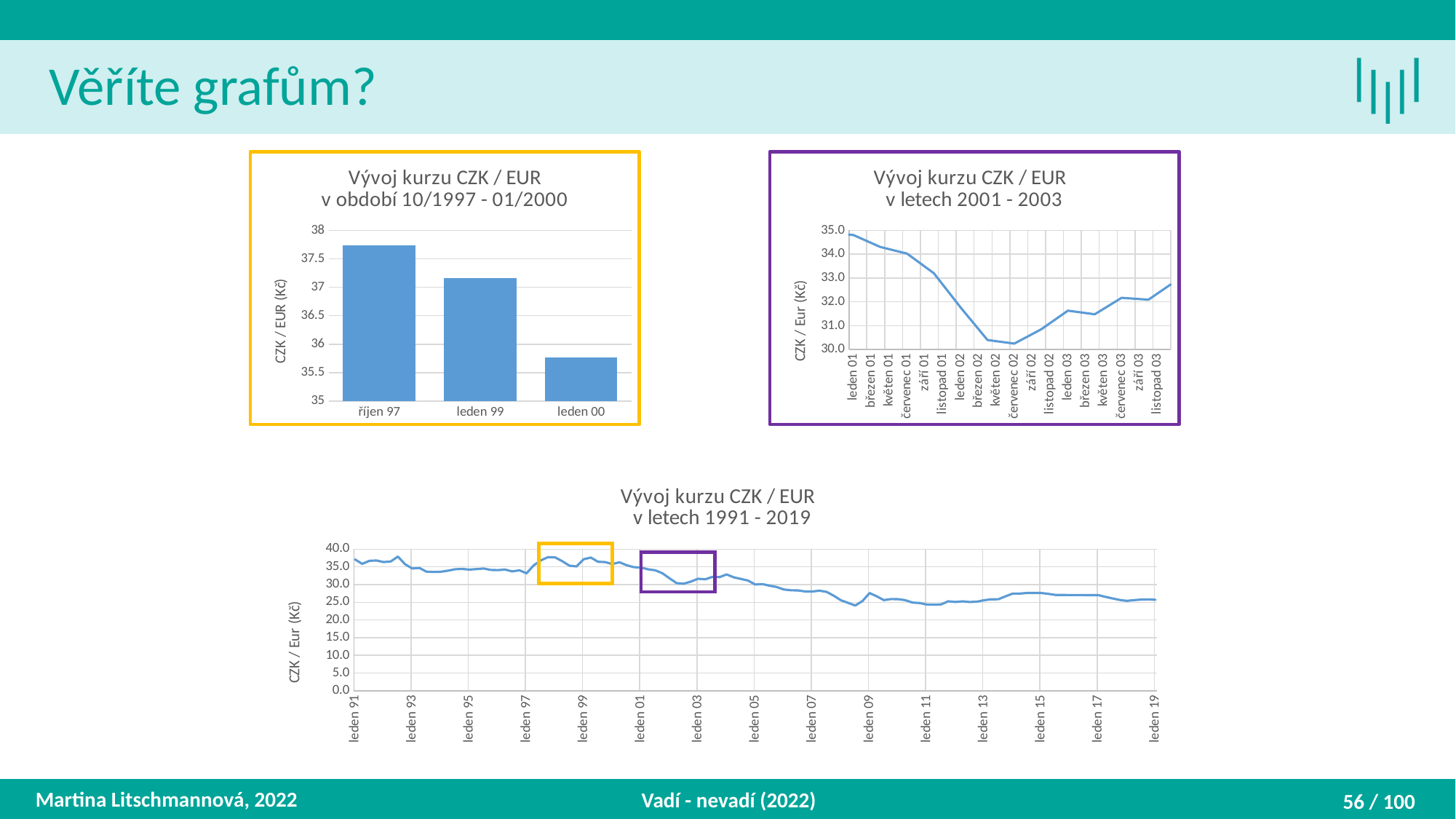
In the bottom chart 'Vývoj kurzu CZK / EUR v letech 1991 - 2019', is the value for leden 19 greater or less than 30.0? less In the top-left bar chart, which is larger, the value for leden 99 or the value for leden 00? leden 99 In the top-left bar chart, which category has the highest value? říjen 97 In the top-left bar chart, is the value for říjen 97 greater or less than 37.5? greater In the top-left bar chart, which category has the lowest value? leden 00 How many bars are shown in the top-left chart 'Vývoj kurzu CZK / EUR v období 10/1997 - 01/2000'? 3 What kind of chart is the top-left chart titled 'Vývoj kurzu CZK / EUR v období 10/1997 - 01/2000'? bar chart In the top-left bar chart, do the values rise or fall from říjen 97 to leden 00? fall In the top-right line chart 'Vývoj kurzu CZK / EUR v letech 2001 - 2003', is the value for leden 01 greater or less than 34.0? greater What kind of chart is the top-right chart titled 'Vývoj kurzu CZK / EUR v letech 2001 - 2003'? line chart What is the y-axis label of the bottom chart 'Vývoj kurzu CZK / EUR v letech 1991 - 2019'? CZK / Eur (Kč)